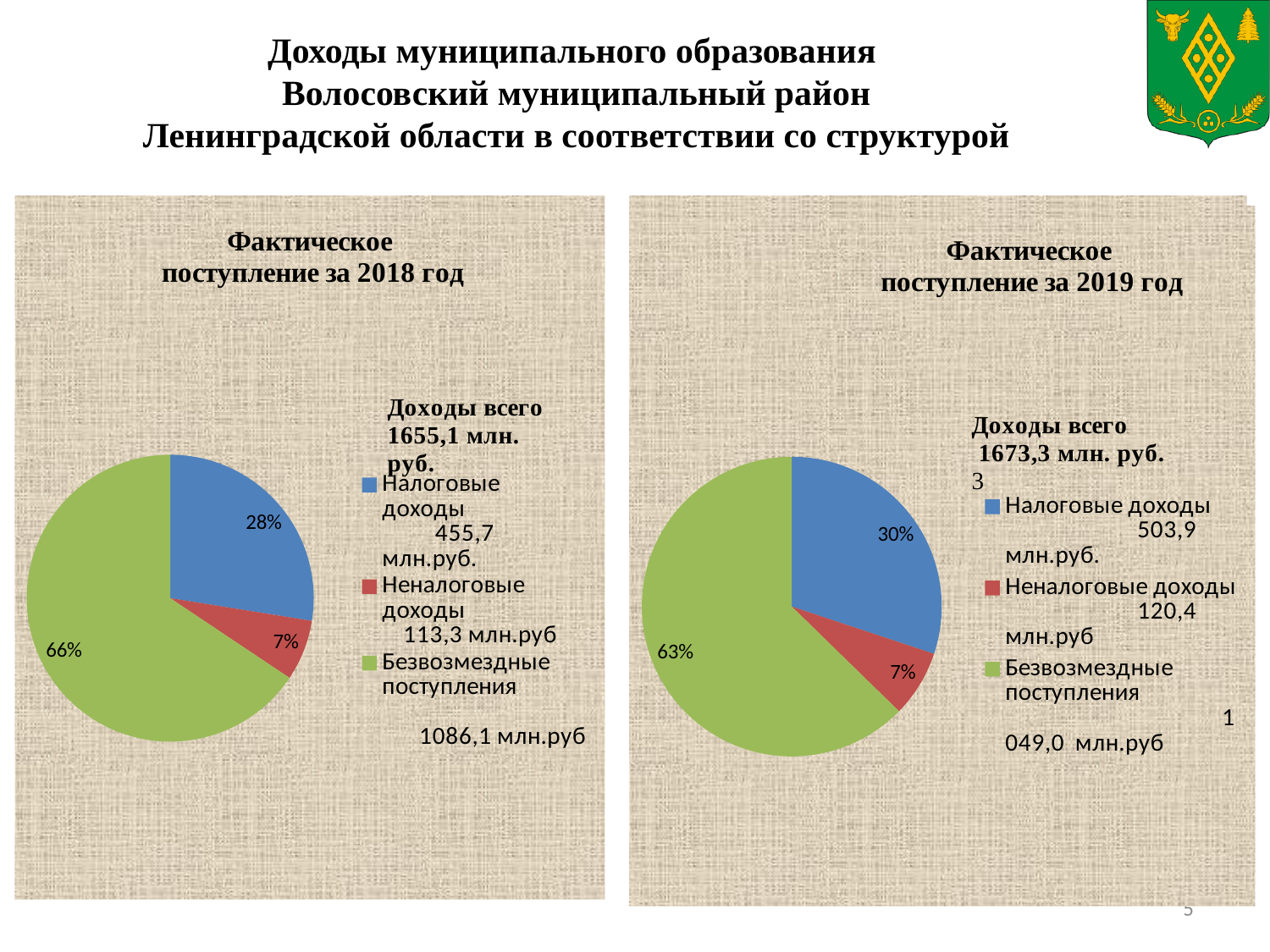
In the chart 'Фактическое поступление за 2019 год', what share of the pie is 'Налоговые доходы'? 30% What kind of chart is 'Фактическое поступление за 2018 год'? Pie chart In the chart 'Фактическое поступление за 2019 год', what share of the pie is 'Неналоговые доходы'? 7% What total income ('Доходы всего') is stated on the chart 'Фактическое поступление за 2019 год'? 1673,3 млн. руб. In the chart 'Фактическое поступление за 2018 год', what share of the pie is 'Безвозмездные поступления'? 66% In the chart 'Фактическое поступление за 2018 год', what value in млн.руб is given for 'Неналоговые доходы' in the legend? 113,3 млн.руб In the chart 'Фактическое поступление за 2019 год', what value in млн.руб is given for 'Налоговые доходы' in the legend? 503,9 млн.руб. Which is larger: the share of 'Налоговые доходы' in the 2018 chart or in the 2019 chart? 2019 chart In the chart 'Фактическое поступление за 2018 год', which category has the largest slice? Безвозмездные поступления How many categories does the legend of the chart 'Фактическое поступление за 2019 год' list? 3 In the chart 'Фактическое поступление за 2019 год', which category has the smallest slice? Неналоговые доходы